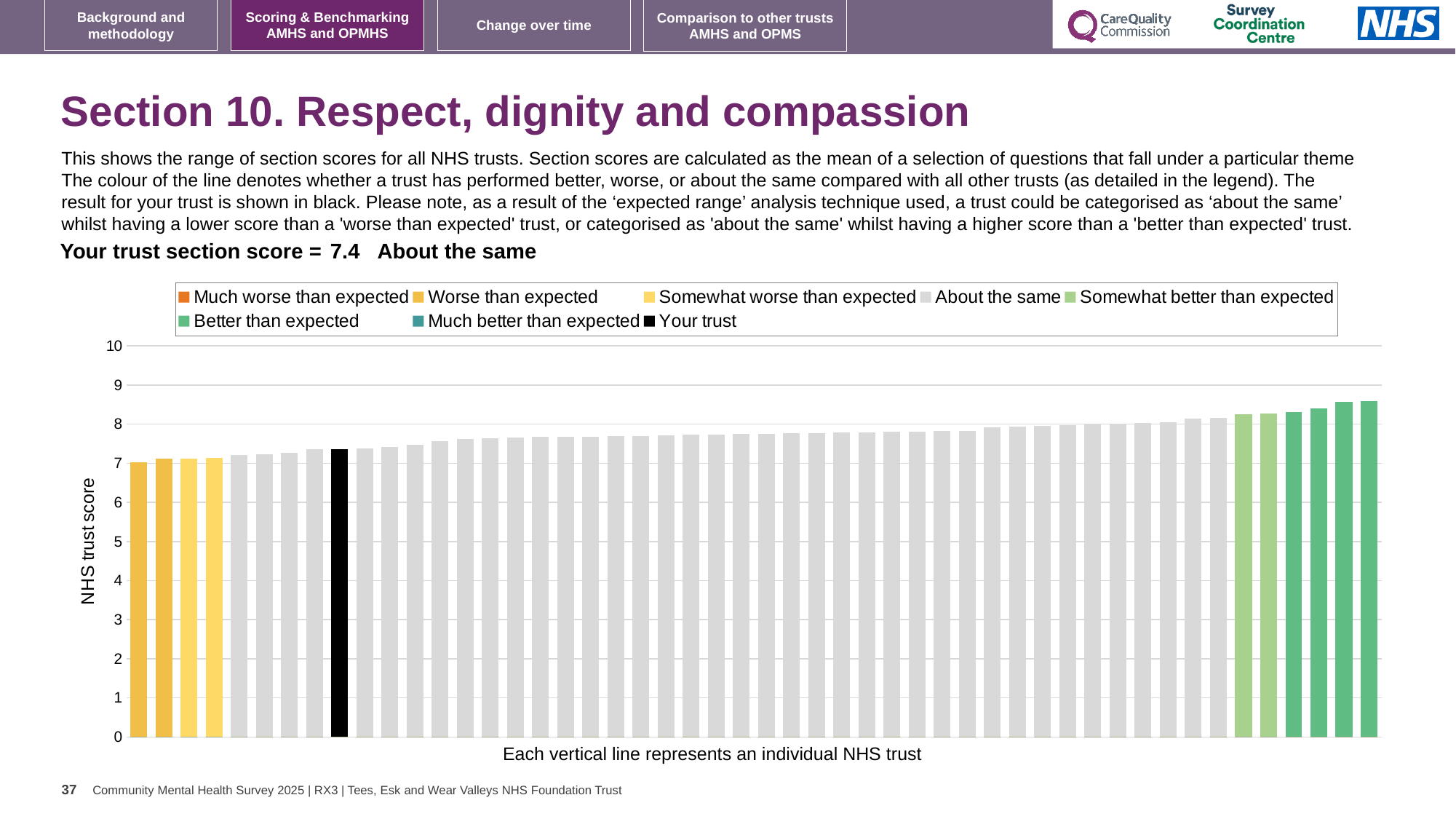
What is the section score for your trust shown on the slide? 7.4 What colour is the bar representing your trust? black Is the value for your trust (the black bar) greater or less than 8? less Is the value for your trust (the black bar) greater or less than 7? greater How many entries does the chart legend list? 8 What is the title of the vertical axis? NHS trust score Which legend category does the highest-scoring trust belong to? Better than expected Is the value of the lowest bar in the chart greater or less than 8? less Do the bar values rise or fall from left to right along the x axis? rise What kind of chart is shown on the slide? bar chart How is your trust's section score categorised compared with other trusts? About the same